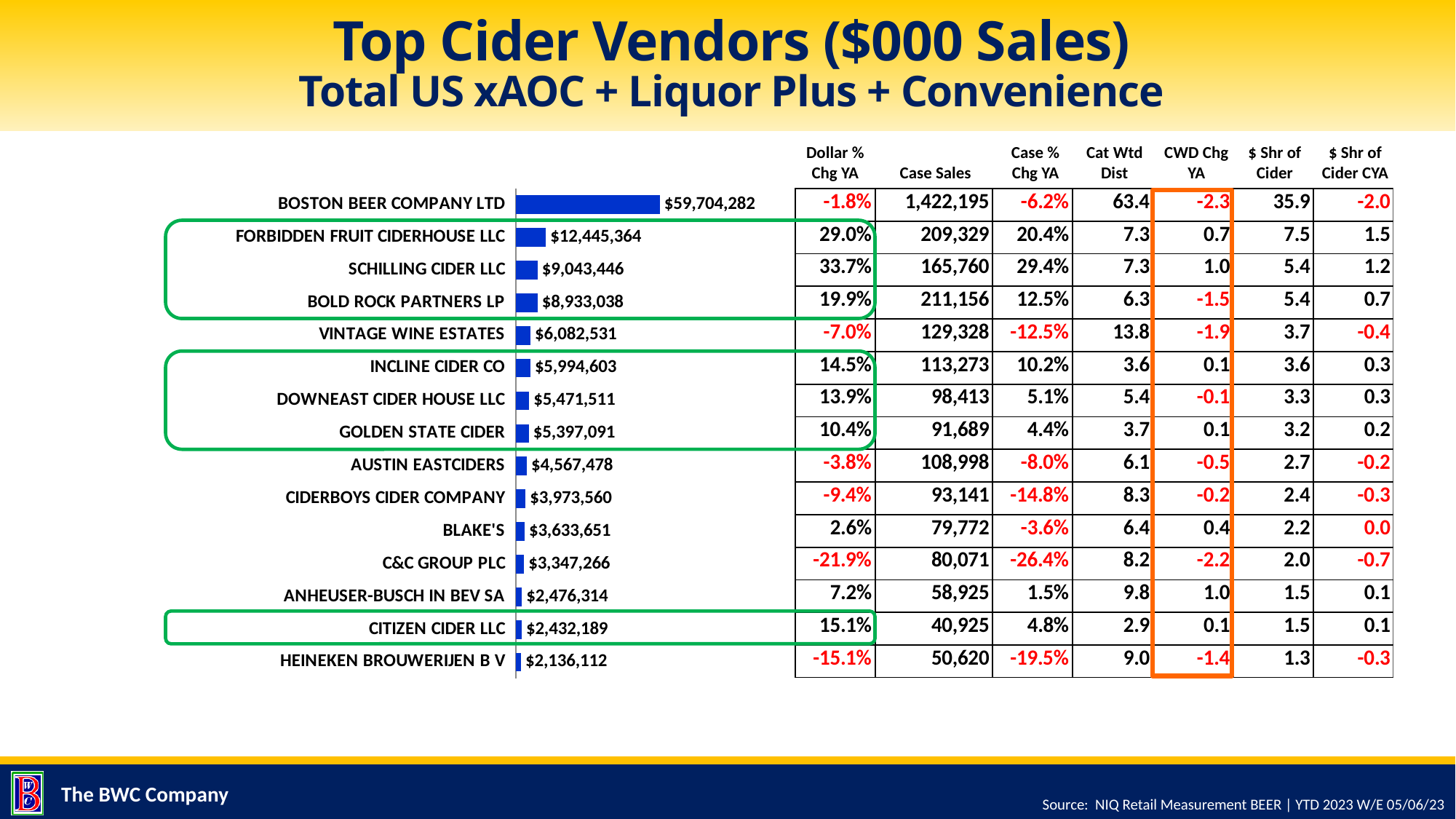
What is the sales value shown for Golden State Cider? $5,397,091 What kind of chart is shown on the slide? bar chart Which vendor has the highest sales value in the chart? Boston Beer Company Ltd What is the difference in sales between Forbidden Fruit Ciderhouse LLC and Schilling Cider LLC? $3,401,918 Which has the larger sales value, Incline Cider Co or Downeast Cider House LLC? Incline Cider Co How many vendors are shown as bars in the chart? 15 Which vendor has the lowest sales value in the chart? Heineken Brouwerijen B V What is the sales value shown for Boston Beer Company Ltd? $59,704,282 Do the bar values increase or decrease going from the top of the chart to the bottom? decrease What is the sales value shown for Citizen Cider LLC? $2,432,189 What is the difference in sales between Boston Beer Company Ltd and Forbidden Fruit Ciderhouse LLC? $47,258,918 What is the sales value shown for C&C Group PLC? $3,347,266